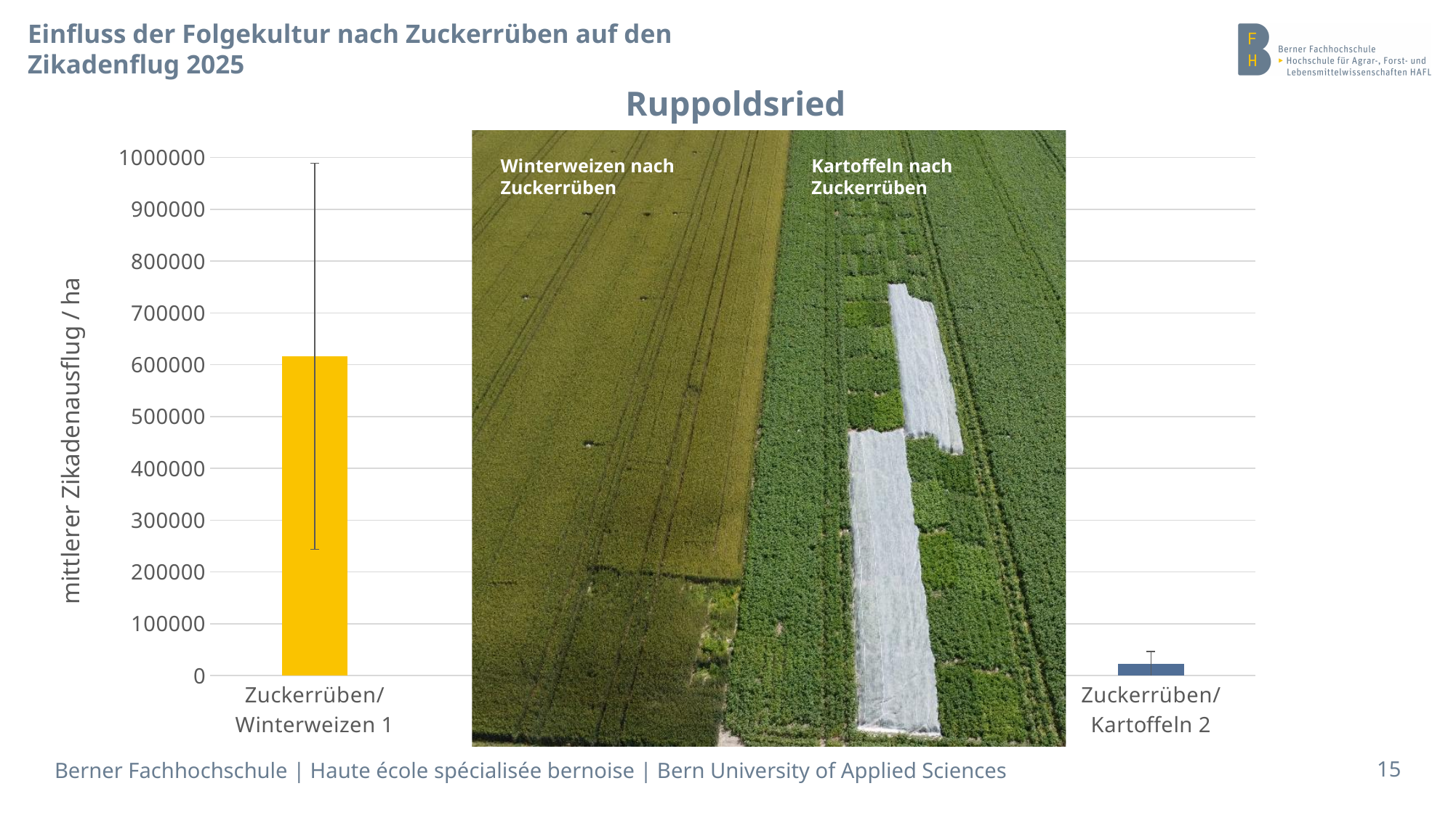
What is the highest value shown on the vertical axis of the chart? 1000000 What kind of chart is shown on the slide? bar chart What is the title of the chart? Ruppoldsried Which of the labelled categories has the highest value? Zuckerrüben/Winterweizen 1 Which of the labelled categories has the lowest value? Zuckerrüben/Kartoffeln 2 Which category has the higher value, Zuckerrüben/Winterweizen 1 or Zuckerrüben/Kartoffeln 2? Zuckerrüben/Winterweizen 1 Is the value for Zuckerrüben/Winterweizen 1 greater or less than 700000? less Is the value for Zuckerrüben/Kartoffeln 2 greater or less than 200000? less Is the value for Zuckerrüben/Kartoffeln 2 greater or less than 100000? less What is the label of the vertical axis of the chart? mittlerer Zikadenausflug / ha